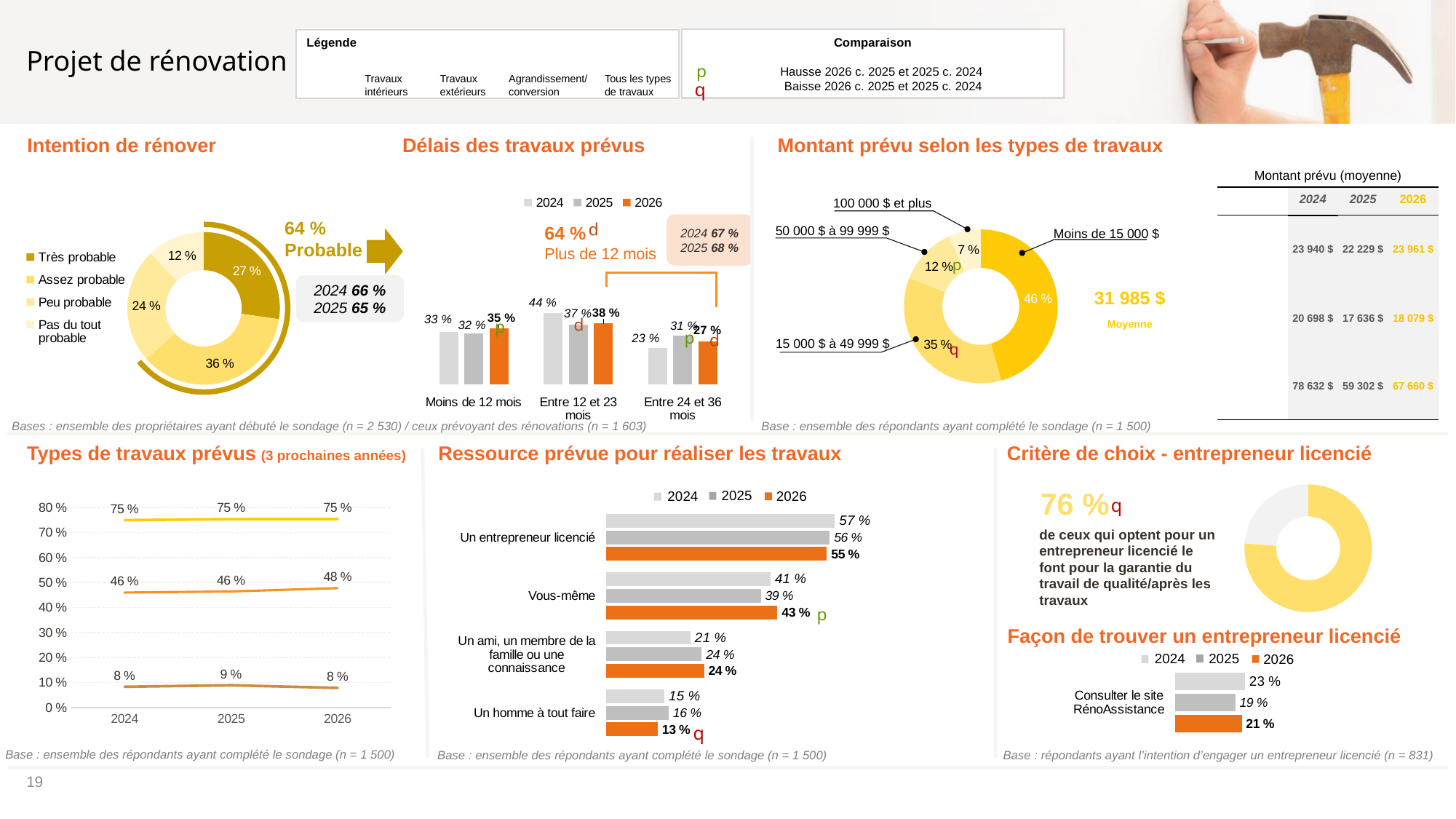
In the 'Façon de trouver un entrepreneur licencié' bar chart, what is the 2025 value for 'Consulter le site RénoAssistance'? 19 % In the 'Montant prévu selon les types de travaux' donut chart, which category has the largest share? Moins de 15 000 $ In the 'Ressource prévue pour réaliser les travaux' bar chart, which is larger: the 2024 value for 'Un entrepreneur licencié' or the 2024 value for 'Un homme à tout faire'? Un entrepreneur licencié In the 'Délais des travaux prévus' bar chart, what is the 2026 value for 'Entre 12 et 23 mois'? 38 % In the 'Délais des travaux prévus' bar chart, how many series does the legend list? 3 In the 'Ressource prévue pour réaliser les travaux' bar chart, what is the 2026 value for 'Vous-même'? 43 % In the 'Intention de rénover' donut chart, which category has the smallest share? Pas du tout probable In the 'Délais des travaux prévus' bar chart, what is the difference between the 2024 and 2025 values for 'Entre 24 et 36 mois'? 8 % What kind of chart is used in the 'Types de travaux prévus' section? Line chart In the 'Intention de rénover' donut chart, what percentage is shown for 'Assez probable'? 36 % In the 'Montant prévu selon les types de travaux' donut chart, what share is shown for '15 000 $ à 49 999 $'? 35 % In the 'Types de travaux prévus' line chart, what is the 2026 value of the middle line? 48 %